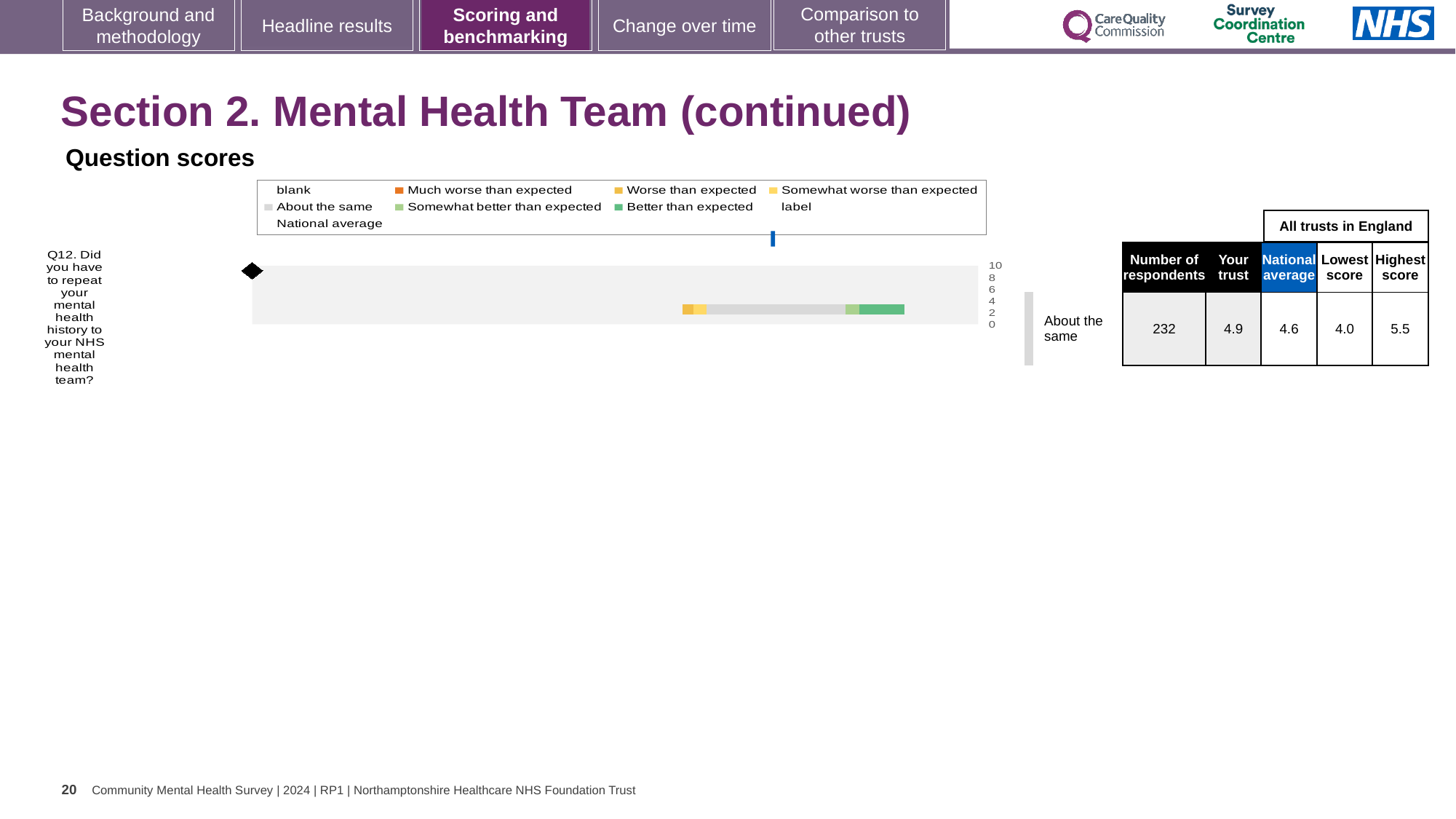
What is the difference between the highest score and the lowest score for Q12? 1.5 What is the 'Your trust' score for Q12 (Did you have to repeat your mental health history to your NHS mental health team?)? 4.9 What kind of chart is used to show the Q12 question score? bar chart Which is larger for Q12, the 'Your trust' score or the national average? Your trust What is the lowest score among all trusts in England for Q12? 4.0 What benchmark category is shown for Q12 next to the chart? About the same What is the highest score among all trusts in England for Q12? 5.5 By how much does the 'Your trust' score exceed the national average for Q12? 0.3 What is the national average score for Q12? 4.6 How many survey questions are plotted on the chart? 1 How many respondents answered Q12? 232 What colour does the legend use for 'Much worse than expected'? orange